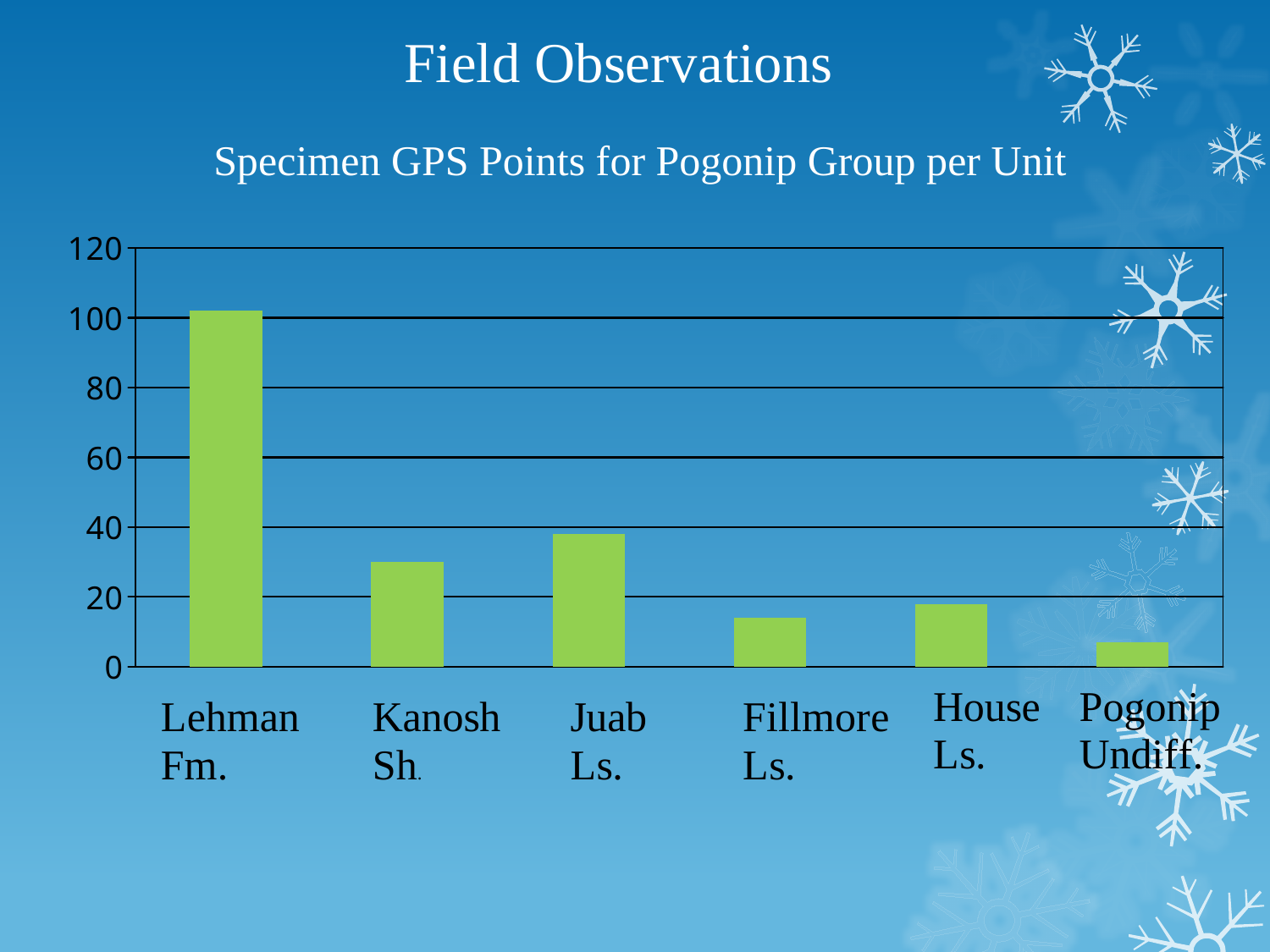
Is the value for Fillmore Ls. greater or less than 20? less How many units (categories) are plotted on the chart? 6 Is the value for Kanosh Sh. greater or less than 40? less Is the value for Pogonip Undiff. greater or less than 20? less What is the title of the chart? Specimen GPS Points for Pogonip Group per Unit Which unit has the highest number of specimen GPS points? Lehman Fm. Which has more specimen GPS points, Juab Ls. or Kanosh Sh.? Juab Ls. Which unit has the lowest number of specimen GPS points? Pogonip Undiff. What kind of chart is shown on the slide? bar chart Which has more specimen GPS points, Lehman Fm. or Juab Ls.? Lehman Fm.